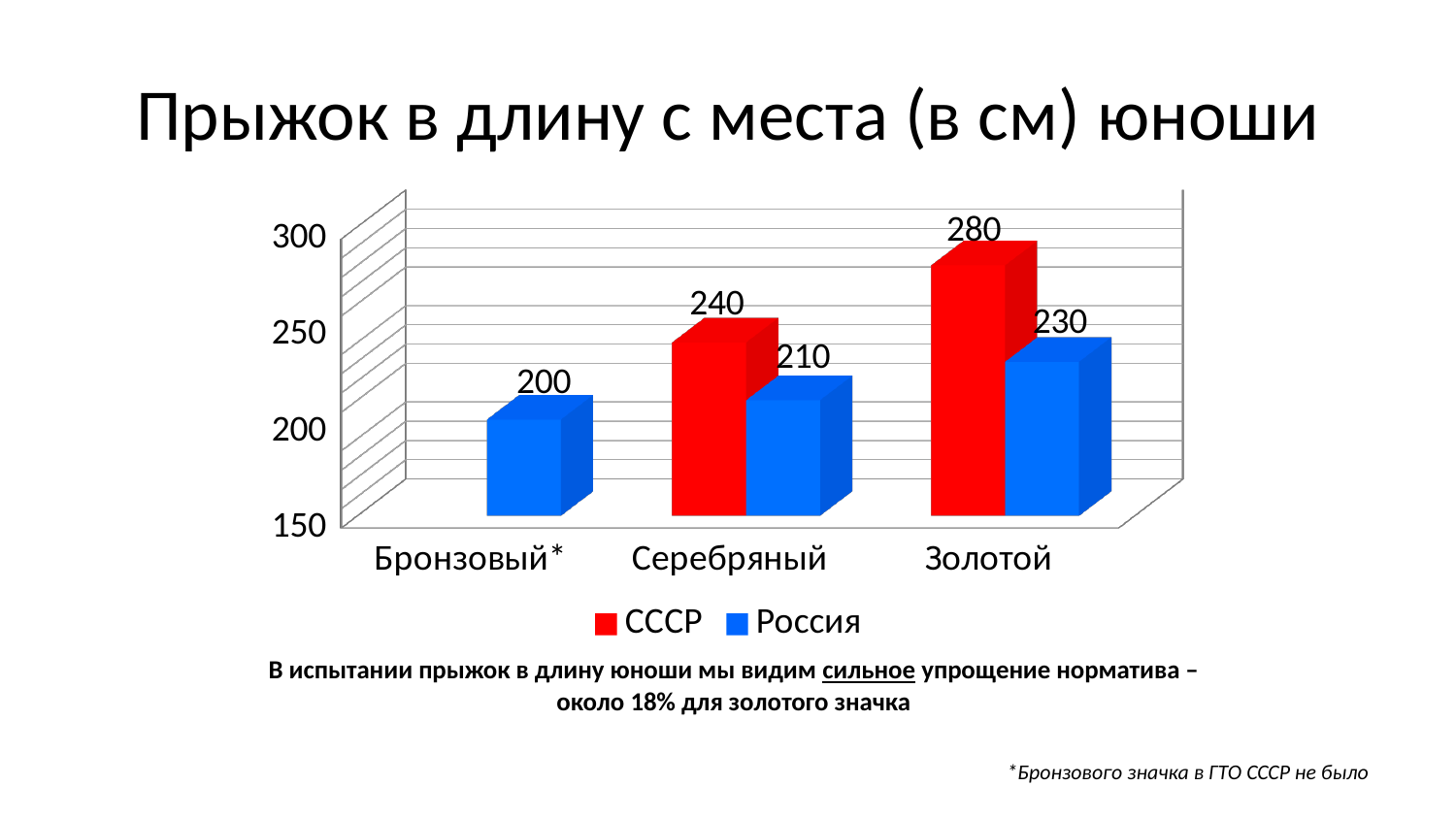
How many categories are shown on the x axis? 3 Which category has the highest value for the Россия series? Золотой Which category has the lowest value for the Россия series? Бронзовый* What is the value for Россия in the Серебряный category? 210 What is the value for Россия in the Бронзовый* category? 200 What is the value for СССР in the Золотой category? 280 Which is larger in the Серебряный category: the СССР value or the Россия value? СССР What is the value for СССР in the Серебряный category? 240 How many series does the legend list? 2 What is the difference between the СССР and Россия values in the Золотой category? 50 What is the title of the chart? Прыжок в длину с места (в см) юноши What kind of chart is shown on the slide? Bar chart